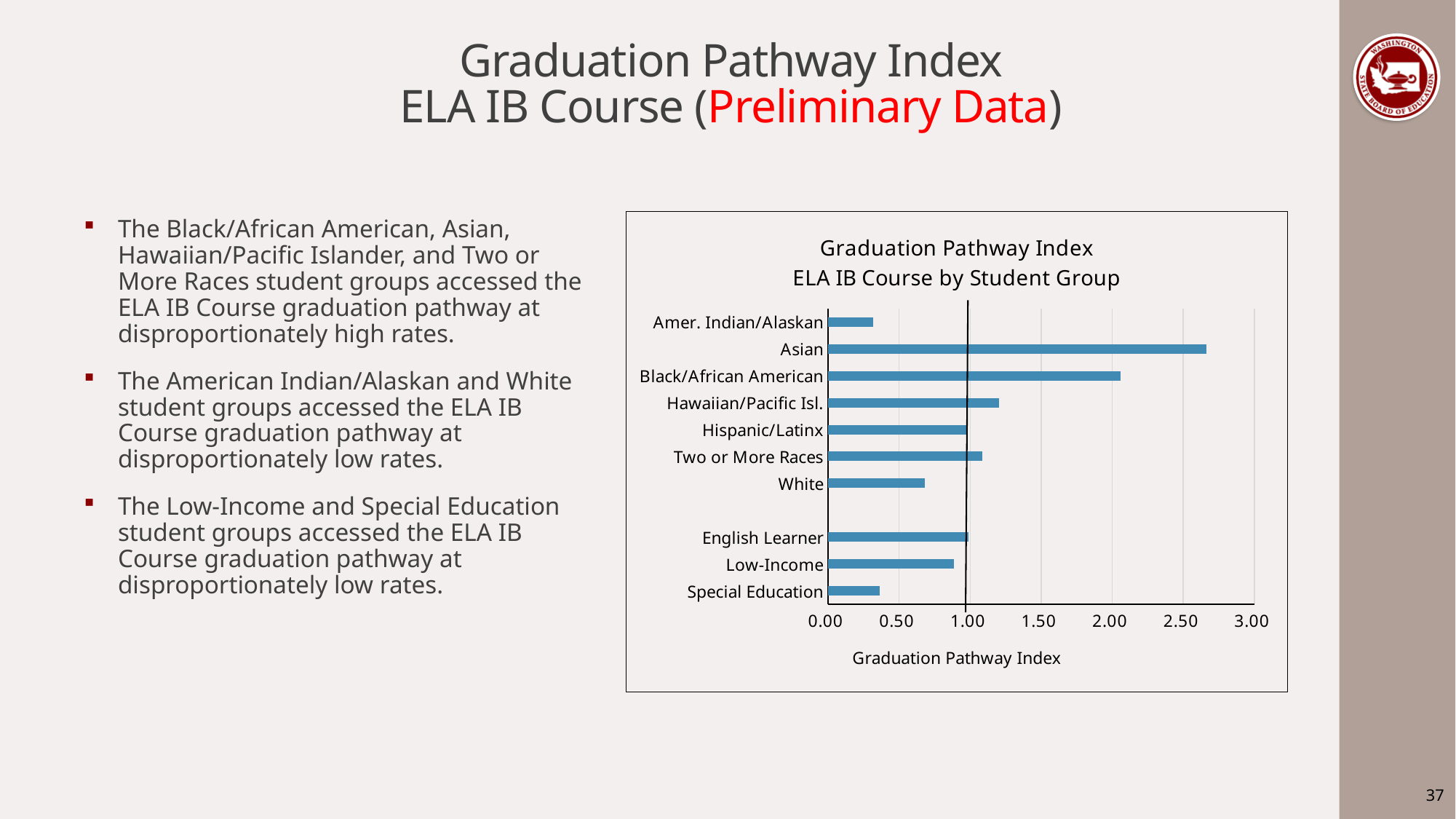
Is the Graduation Pathway Index for Hawaiian/Pacific Isl. greater or less than 1.00? greater Which has a higher Graduation Pathway Index, White or Hawaiian/Pacific Isl.? Hawaiian/Pacific Isl. How many student groups are plotted in the chart? 10 What is the label on the horizontal axis of the chart? Graduation Pathway Index Which student group has the highest Graduation Pathway Index in the chart? Asian Which has a higher Graduation Pathway Index, Asian or Black/African American? Asian What is the title of the chart? Graduation Pathway Index ELA IB Course by Student Group Is the Graduation Pathway Index for Asian greater or less than 2.50? greater Is the Graduation Pathway Index for White greater or less than 1.00? less What kind of chart is shown on the slide? Bar chart